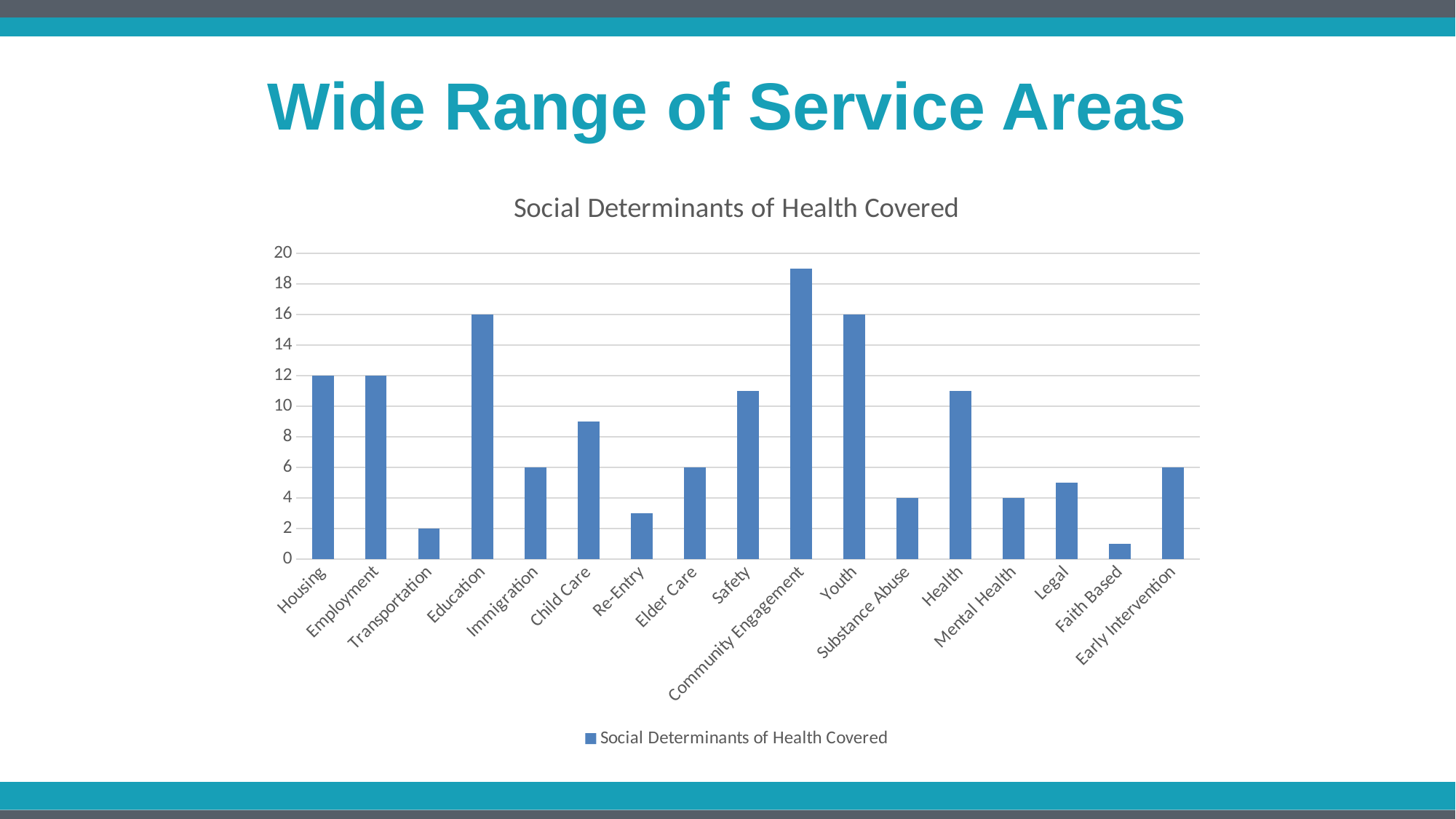
Which category has the lowest value in the chart? Faith Based How many categories are shown on the x axis of the chart? 17 Which is larger, the value for Youth or the value for Employment? Youth What type of chart is shown on the slide? Bar chart What is the difference between the values for Education and Transportation? 14 What is the value for Transportation? 2 Is the value for Community Engagement greater or less than 18? greater What is the title of the chart? Social Determinants of Health Covered What is the value for Housing? 12 How many series does the legend list? 1 Which category has the highest value in the chart? Community Engagement What is the value for Education? 16